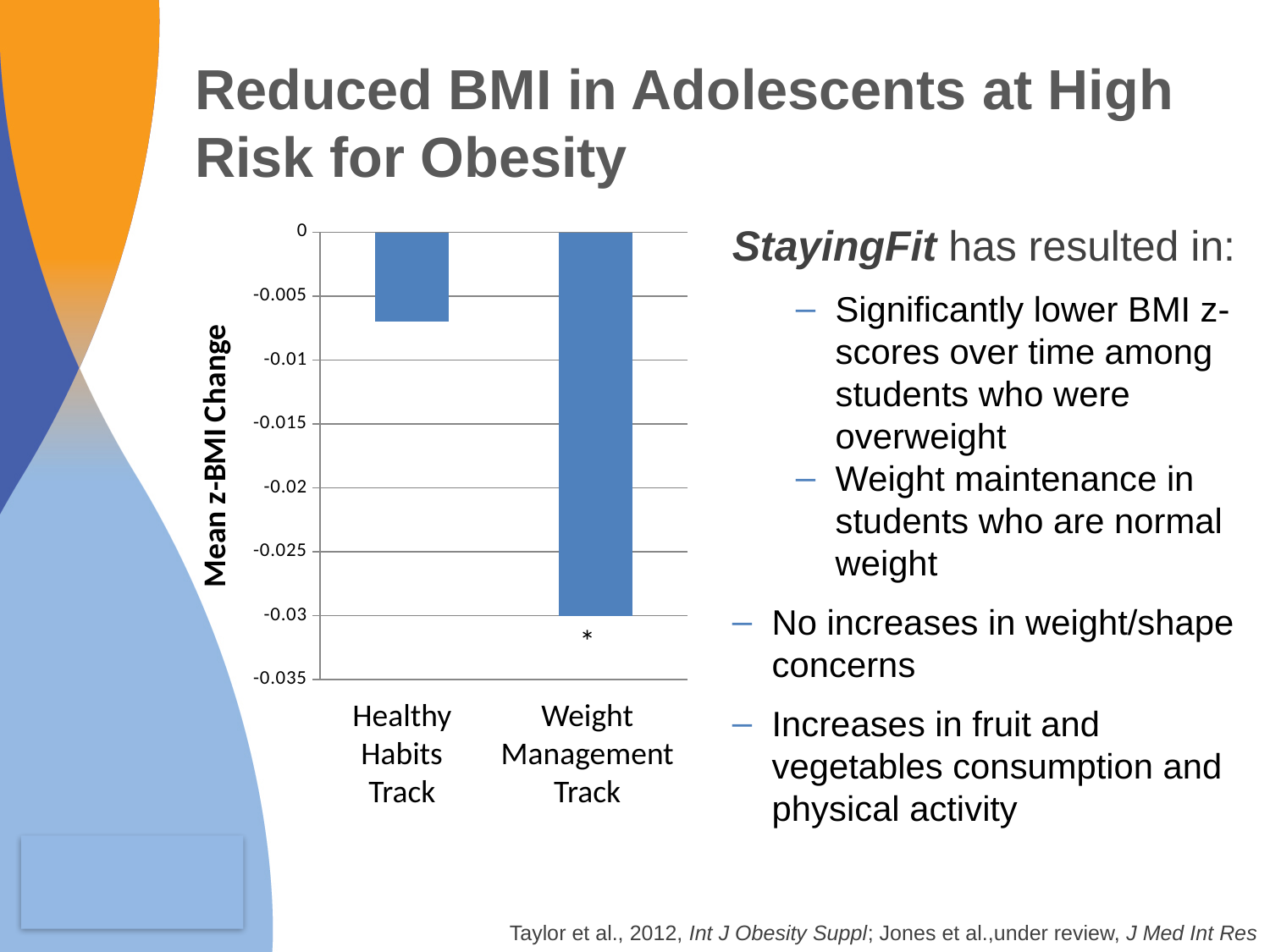
What is the label on the vertical axis of the chart? Mean z-BMI Change Which track has a larger reduction in mean z-BMI, Healthy Habits Track or Weight Management Track? Weight Management Track Which bar on the chart is marked with an asterisk? Weight Management Track Is the mean z-BMI change for the Healthy Habits Track greater or less than -0.005? less Do the values rise or fall moving from the Healthy Habits Track to the Weight Management Track? fall What kind of chart is shown on the slide? bar chart Which track shows the highest (least negative) mean z-BMI change? Healthy Habits Track What is the mean z-BMI change for the Weight Management Track? -0.03 Which track shows the lowest (most negative) mean z-BMI change? Weight Management Track Is the mean z-BMI change for the Healthy Habits Track greater or less than -0.01? greater How many categories are plotted on the chart? 2